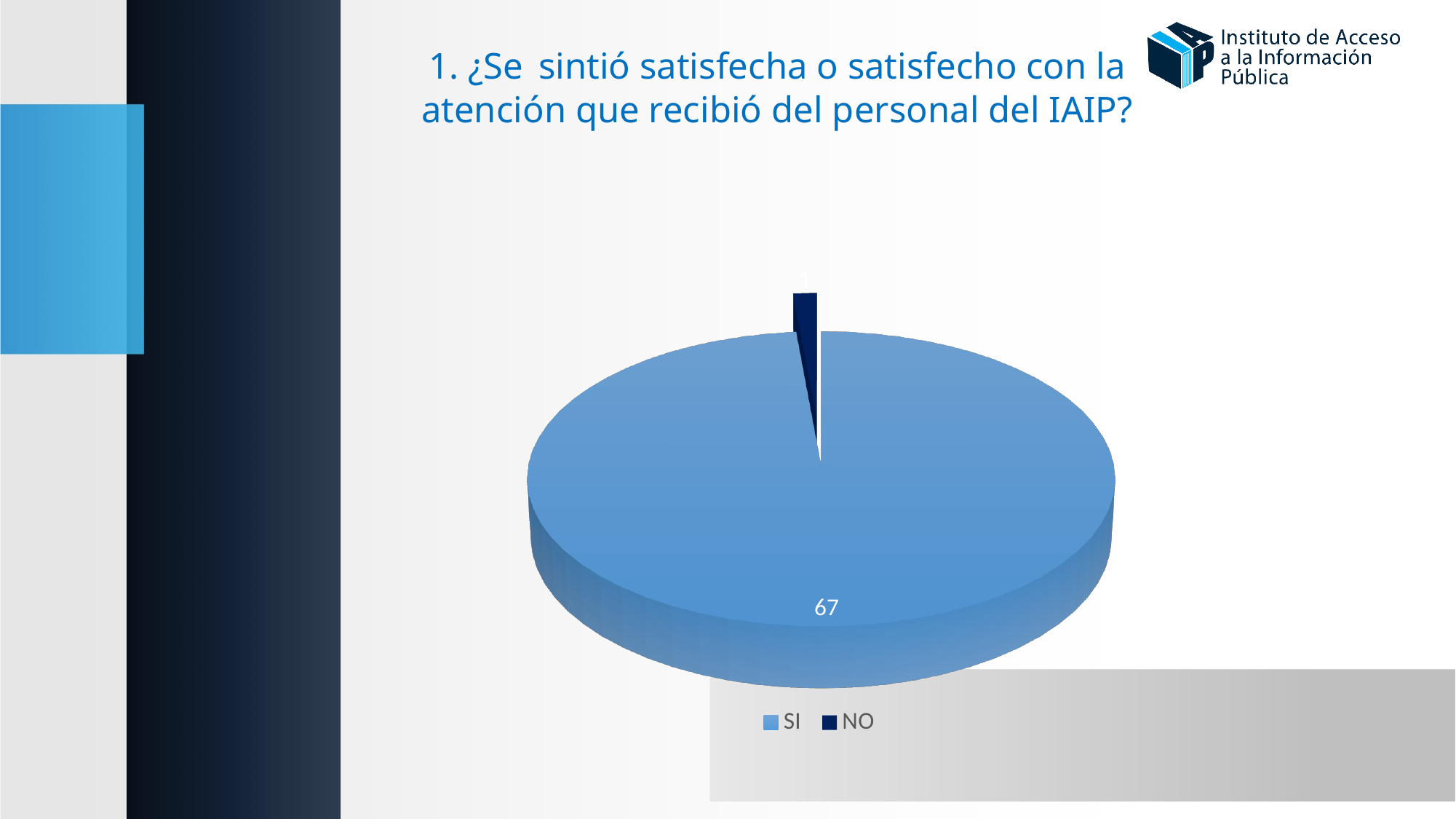
Which is larger, the value for SI or the value for NO? SI What kind of chart is shown on the slide? Pie chart Which category has the largest slice of the pie? SI What is the value for the SI slice? 67 Which legend entry is shown in dark navy blue? NO What is the value for the NO slice? 1 How many categories does the pie chart have? 2 Which category has the smallest slice of the pie? NO What question is the chart answering, according to the slide title? 1. ¿Se sintió satisfecha o satisfecho con la atención que recibió del personal del IAIP? What is the difference between the SI value and the NO value? 66 How many entries does the legend list? 2